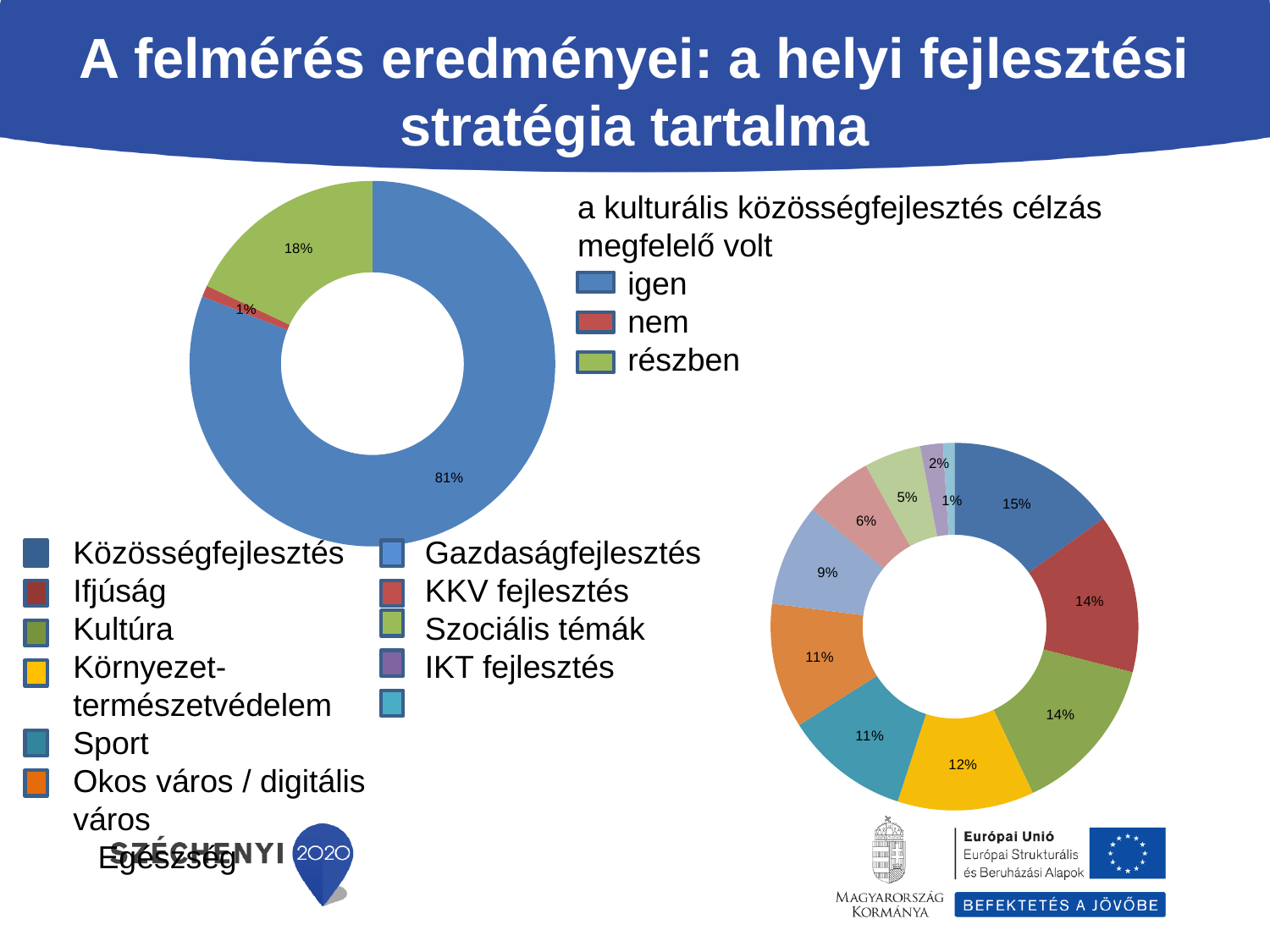
In the top-left chart, which category has the largest share? igen In the bottom-right chart, which category has the largest share? Közösségfejlesztés In the top-left chart, what percentage is shown for 'részben'? 18% In the top-left chart, what percentage is shown for 'igen'? 81% In the top-left chart, how many percentage points larger is 'igen' than 'részben'? 63% In the top-left chart, what percentage is shown for 'nem'? 1% How many entries does the legend of the top-left chart list? 3 In the bottom-right chart, what percentage is shown for Környezet-természetvédelem? 12% In the bottom-right chart, which is larger: Ifjúság or Sport? Ifjúság In the top-left chart, which category has the smallest share? nem What kind of chart is the top-left chart on the slide? doughnut chart In the bottom-right chart, what percentage is shown for Közösségfejlesztés? 15%